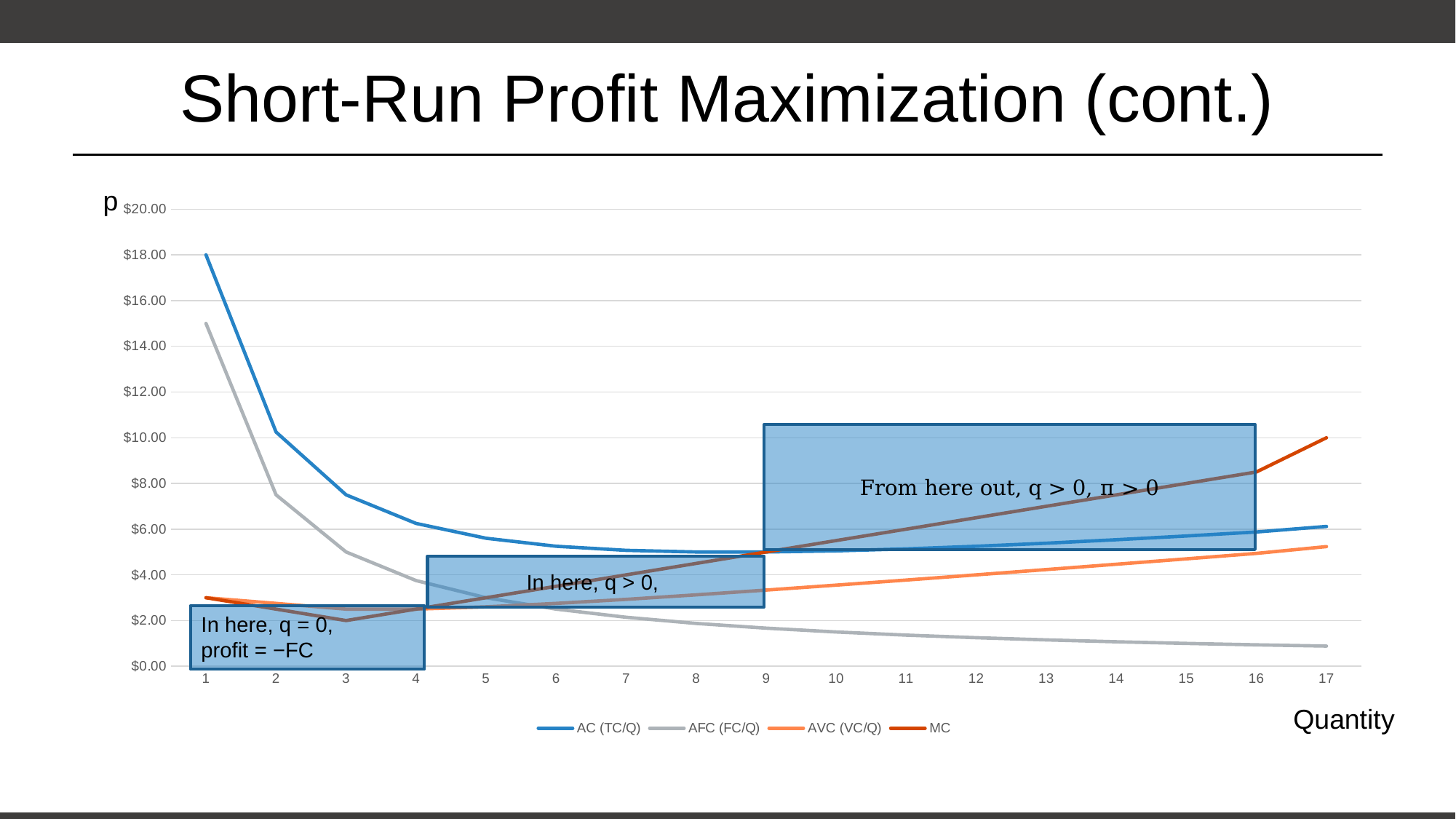
Is the value of MC at quantity 3 greater or less than $4.00? less What is the value of MC at quantity 17? $10.00 What is the value of AC (TC/Q) at quantity 1? $18.00 What kind of chart is shown on the slide? line chart How many series does the chart's legend list? 4 Which series has the highest value at quantity 1? AC (TC/Q) How many quantity values are marked along the x axis? 17 Which series has the lowest value at quantity 17? AFC (FC/Q) At quantity 17, which is larger: MC or AC (TC/Q)? MC Is the value of AFC (FC/Q) at quantity 17 greater or less than $2.00? less Is the value of AVC (VC/Q) at quantity 17 greater or less than $4.00? greater Does the AFC (FC/Q) line rise or fall as quantity increases? fall